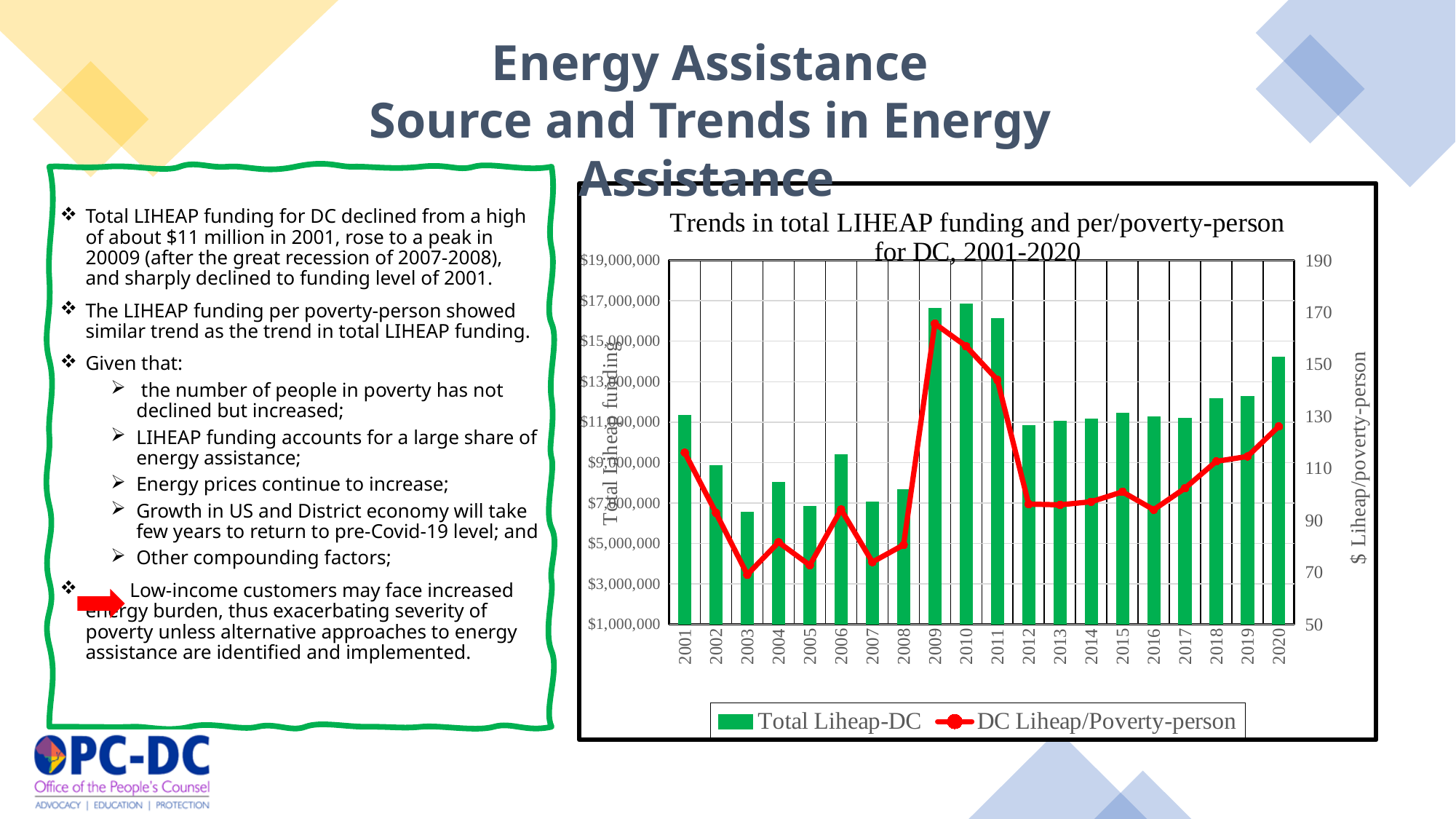
Which year has the larger Total Liheap-DC bar, 2009 or 2002? 2009 In which year does the DC Liheap/Poverty-person line reach its highest point? 2009 How many series does the chart legend list? 2 Is the DC Liheap/Poverty-person value for 2009 greater or less than 150? greater In which year is the Total Liheap-DC bar the lowest? 2003 What kind of chart is shown on the slide? A combined bar and line chart Is the Total Liheap-DC value for 2010 greater or less than $15,000,000? greater How many years are shown along the x axis of the chart? 20 Do the Total Liheap-DC bars generally rise or fall from 2001 to 2003? fall Is the Total Liheap-DC value for 2003 greater or less than $7,000,000? less What is the title of the chart on the slide? Trends in total LIHEAP funding and per/poverty-person for DC, 2001-2020 In which year is the Total Liheap-DC bar the highest? 2010